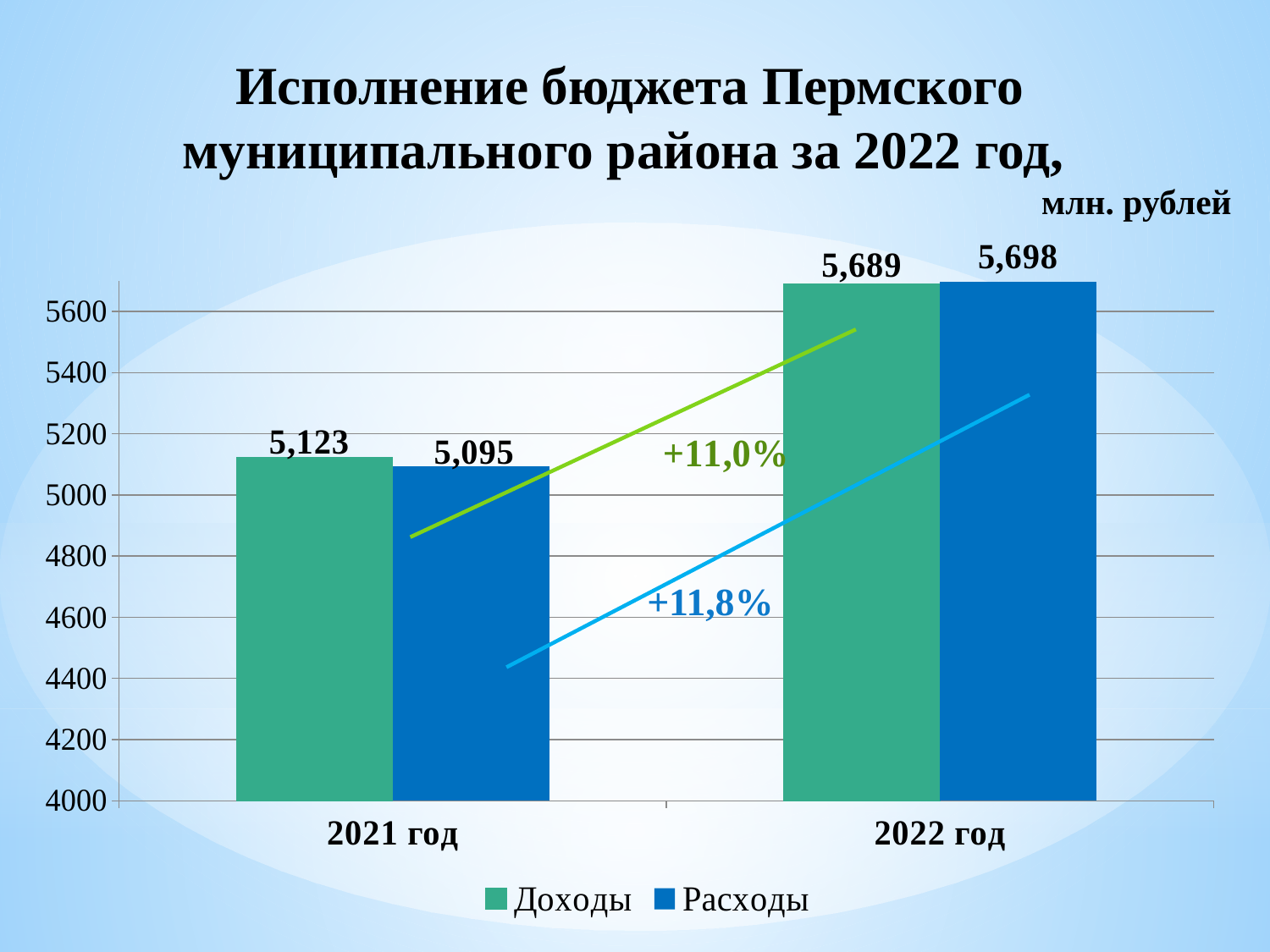
Which bar has the highest value on the chart? Расходы, 2022 год Which is larger in 2022 год, Доходы or Расходы? Расходы What is the value of Доходы for 2021 год? 5,123 What kind of chart is shown on the slide? Bar chart By how much did Доходы increase from 2021 год to 2022 год? 566 What is the value of Расходы for 2021 год? 5,095 What is the difference between Доходы and Расходы in 2021 год? 28 What percentage growth is shown for Расходы between 2021 год and 2022 год? +11,8% Which bar has the lowest value on the chart? Расходы, 2021 год How many series does the legend list? 2 What is the value of Доходы for 2022 год? 5,689 What is the value of Расходы for 2022 год? 5,698